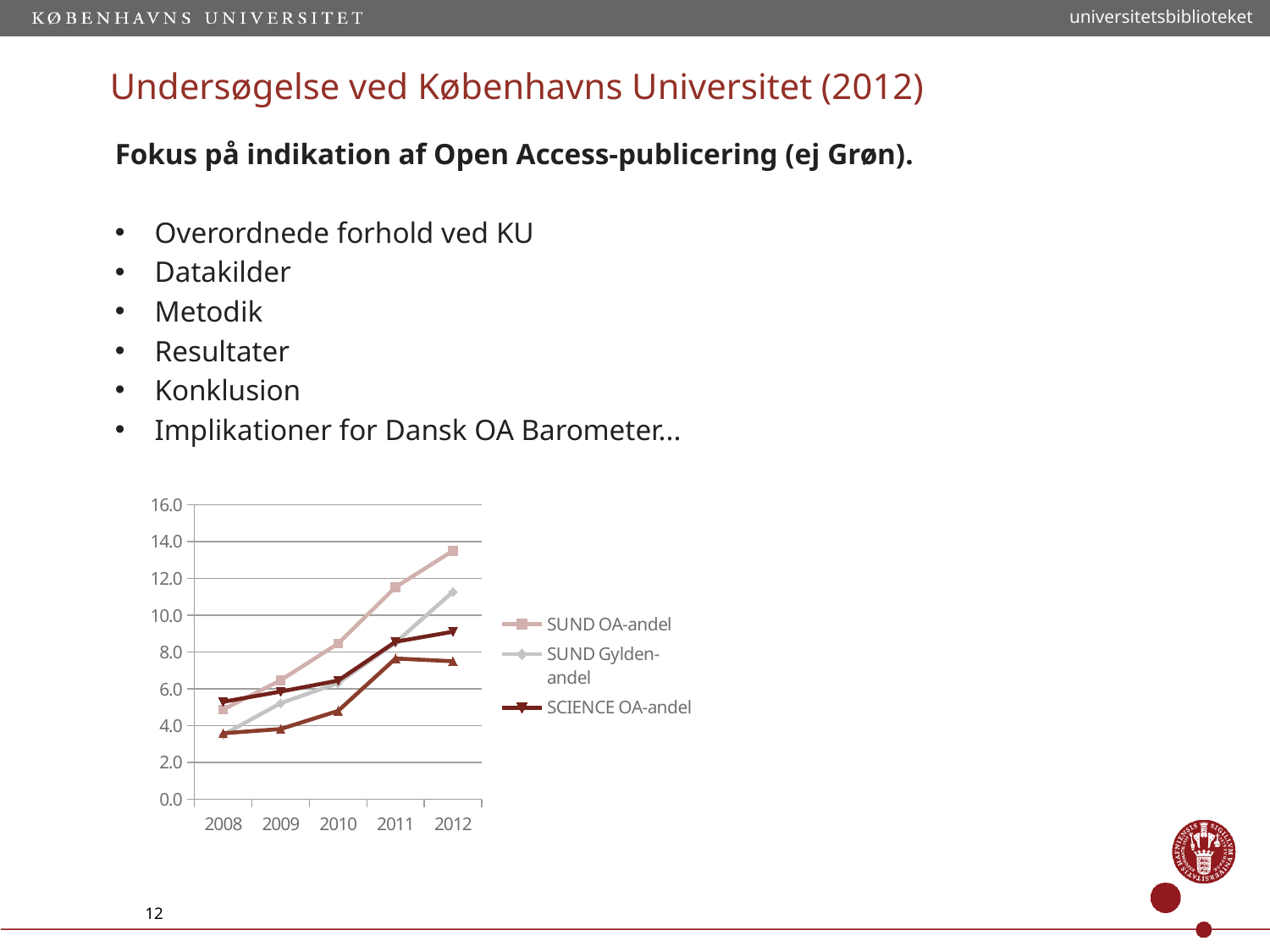
Is the value for SUND OA-andel in 2012 greater or less than 12.0? greater Is the value for SUND Gylden-andel in 2012 greater or less than 10.0? greater How many years are shown on the x axis of the chart? 5 In which year is SUND OA-andel highest? 2012 What kind of chart is shown on the slide? line chart In which year is SUND OA-andel lowest? 2008 Is the value for SUND OA-andel in 2008 greater or less than 6.0? less In 2012, which is larger: SUND OA-andel or SCIENCE OA-andel? SUND OA-andel How many series does the chart's legend list? 3 Does the SUND OA-andel series rise or fall from 2008 to 2012? rise What is the first year shown on the chart's x axis? 2008